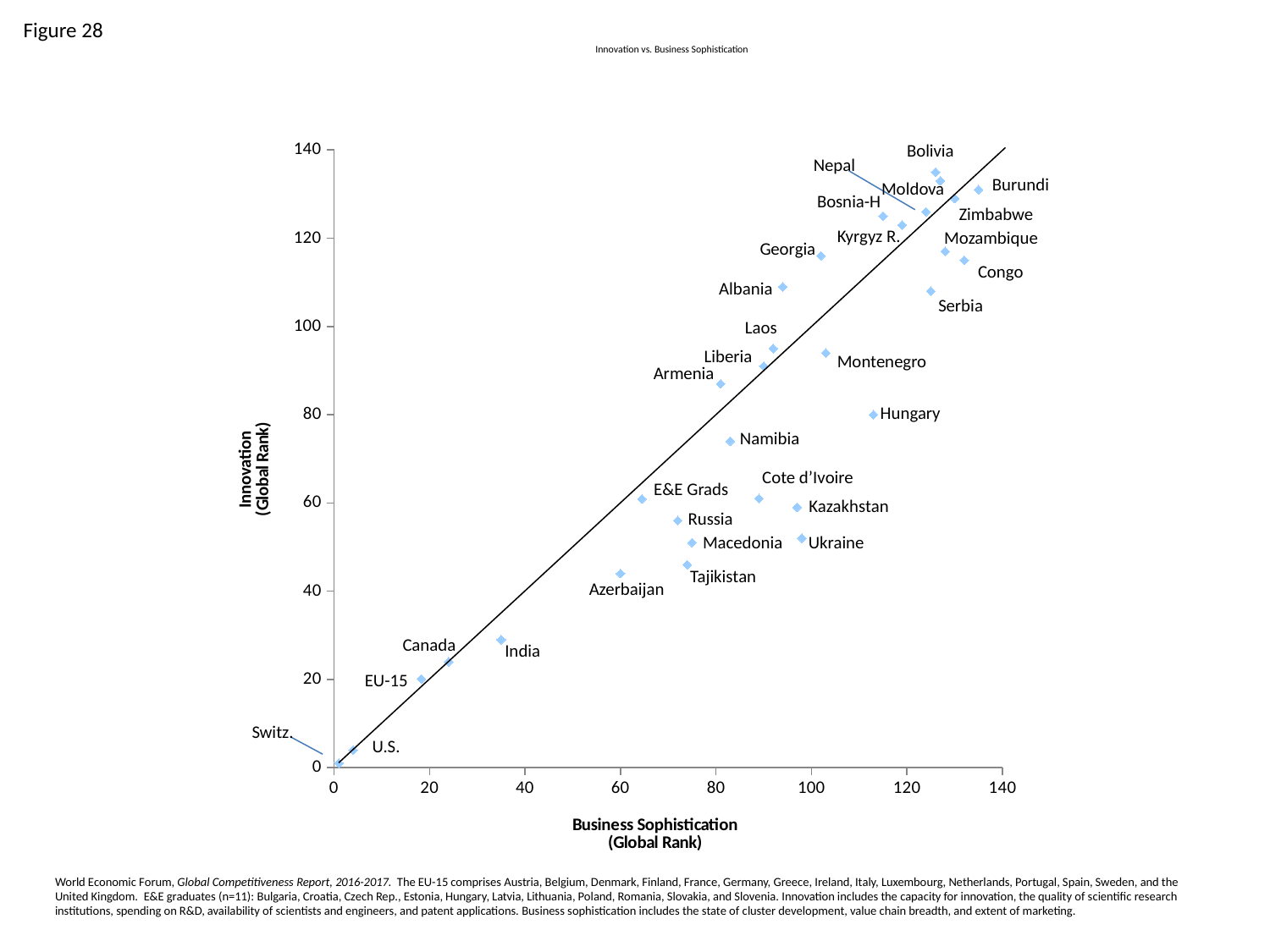
Which labelled point has the lowest Innovation value? Switz. Is the Innovation value for Azerbaijan greater or less than 60? less What is the title of the chart? Innovation vs. Business Sophistication Is the Business Sophistication value for Canada greater or less than 40? less Is the Innovation value for Albania greater or less than 100? greater Which has the higher Business Sophistication value, Canada or India? India Which has the higher Innovation value, Georgia or Montenegro? Georgia What kind of chart is shown on the slide? scatter chart What is the label of the horizontal axis? Business Sophistication (Global Rank)